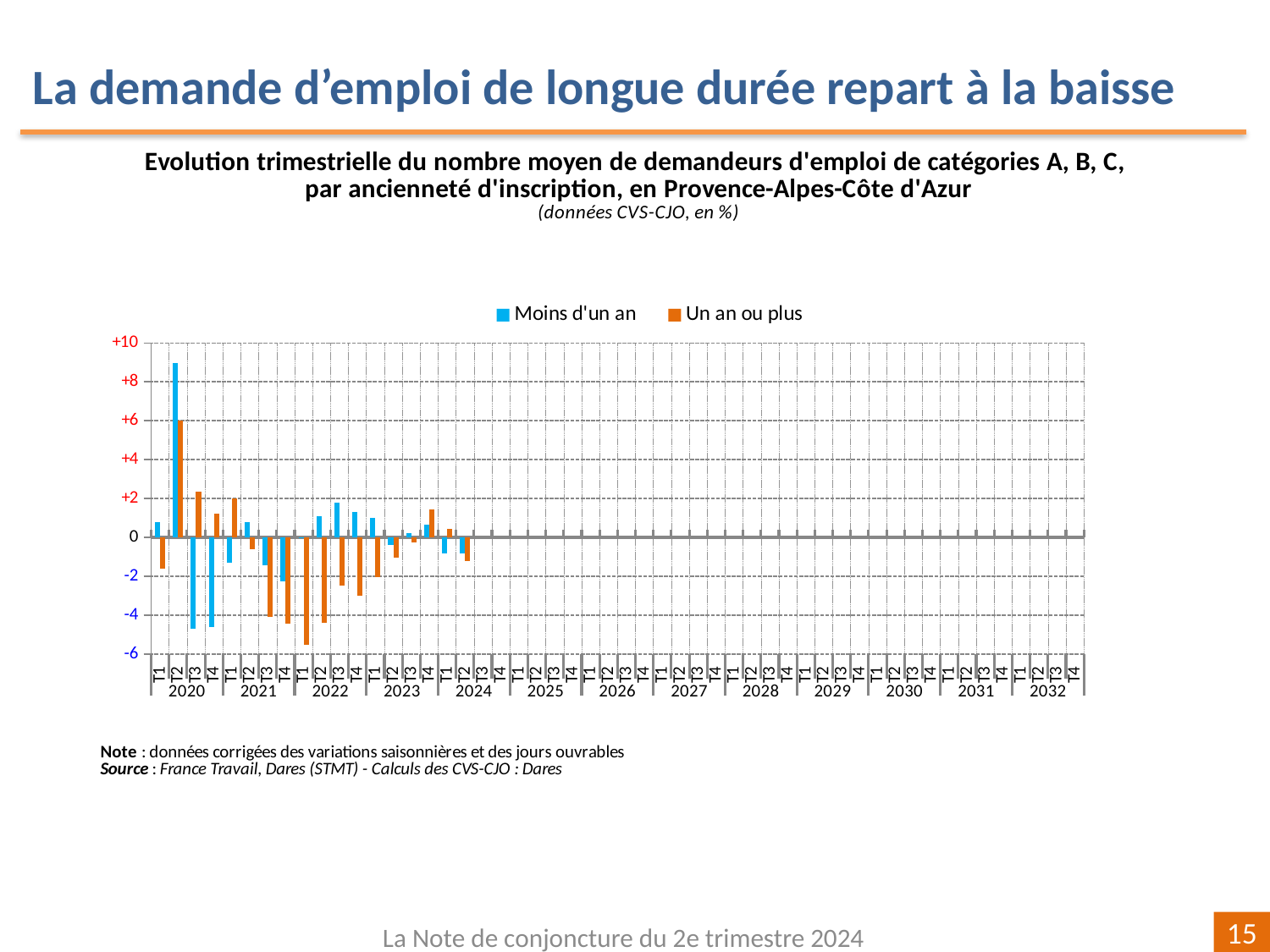
Is the value for 'Un an ou plus' in T1 2022 greater or less than -4? less In which quarter does the series 'Un an ou plus' reach its lowest value? T1 2022 Which colour represents the series 'Un an ou plus'? orange In which quarter does the series 'Moins d'un an' reach its highest value? T2 2020 What is the last quarter for which data is plotted on the chart? T2 2024 Is the value for 'Moins d'un an' in T3 2020 greater or less than -4? less What kind of chart is shown on the slide? bar chart What are the two series named in the legend? Moins d'un an; Un an ou plus In T2 2020, which series has the larger value, 'Moins d'un an' or 'Un an ou plus'? Moins d'un an How many series does the legend list? 2 In which quarter does the series 'Un an ou plus' reach its highest value? T2 2020 Is the value for 'Moins d'un an' in T2 2020 greater or less than +8? greater